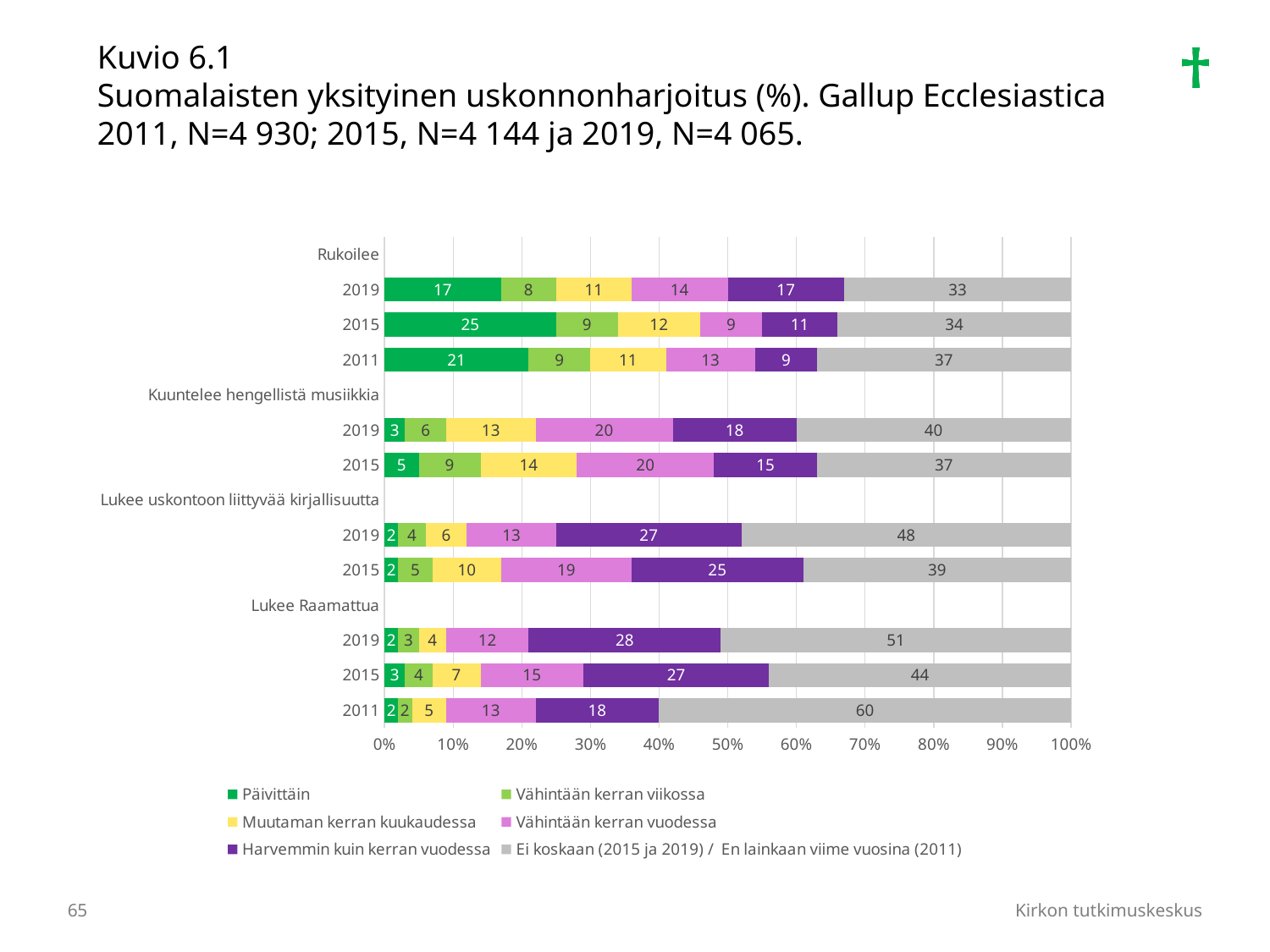
What is the value of Päivittäin for Rukoilee in 2019? 17 What is the value of Vähintään kerran vuodessa for Kuuntelee hengellistä musiikkia in 2015? 20 What is the difference between the Päivittäin values for Rukoilee in 2015 and 2019? 8 Which bar has the highest Päivittäin value? Rukoilee 2015 How many bars are plotted in the chart? 10 What kind of chart is shown on the slide? Stacked bar chart Which colour represents Päivittäin in the legend? Green What is the value of Harvemmin kuin kerran vuodessa for Lukee uskontoon liittyvää kirjallisuutta in 2019? 27 What is the value of the grey 'Ei koskaan' segment for Lukee Raamattua in 2019? 51 How many series does the legend list? 6 What is the total of the stacked bar for Rukoilee 2019? 100 For Lukee Raamattua, which year has the larger 'En lainkaan viime vuosina / Ei koskaan' value, 2011 or 2015? 2011